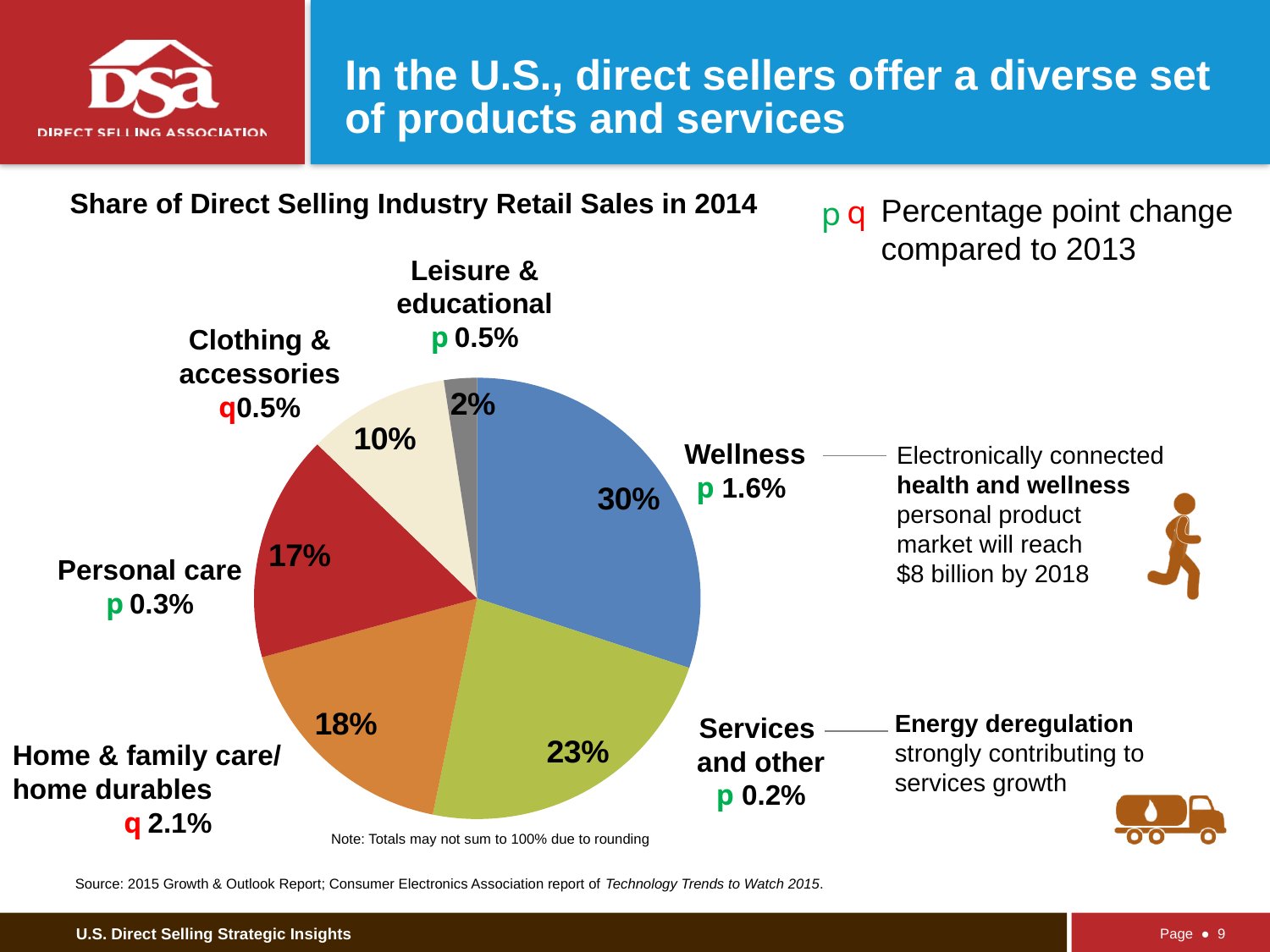
What share of retail sales does Clothing & accessories account for? 10% What share of retail sales does Home & family care/home durables account for? 18% What is the difference in share between Wellness and Services and other? 7 percentage points How many categories are shown in the pie chart? 6 Which has a larger share, Personal care or Clothing & accessories? Personal care What share of direct selling industry retail sales in 2014 does Wellness account for? 30% What is the title of the pie chart? Share of Direct Selling Industry Retail Sales in 2014 Which category has the smallest share of the pie? Leisure & educational What share of retail sales does Services and other account for? 23% What kind of chart is shown on the slide? pie chart What share of retail sales does Personal care account for? 17% Which category has the largest share of the pie? Wellness